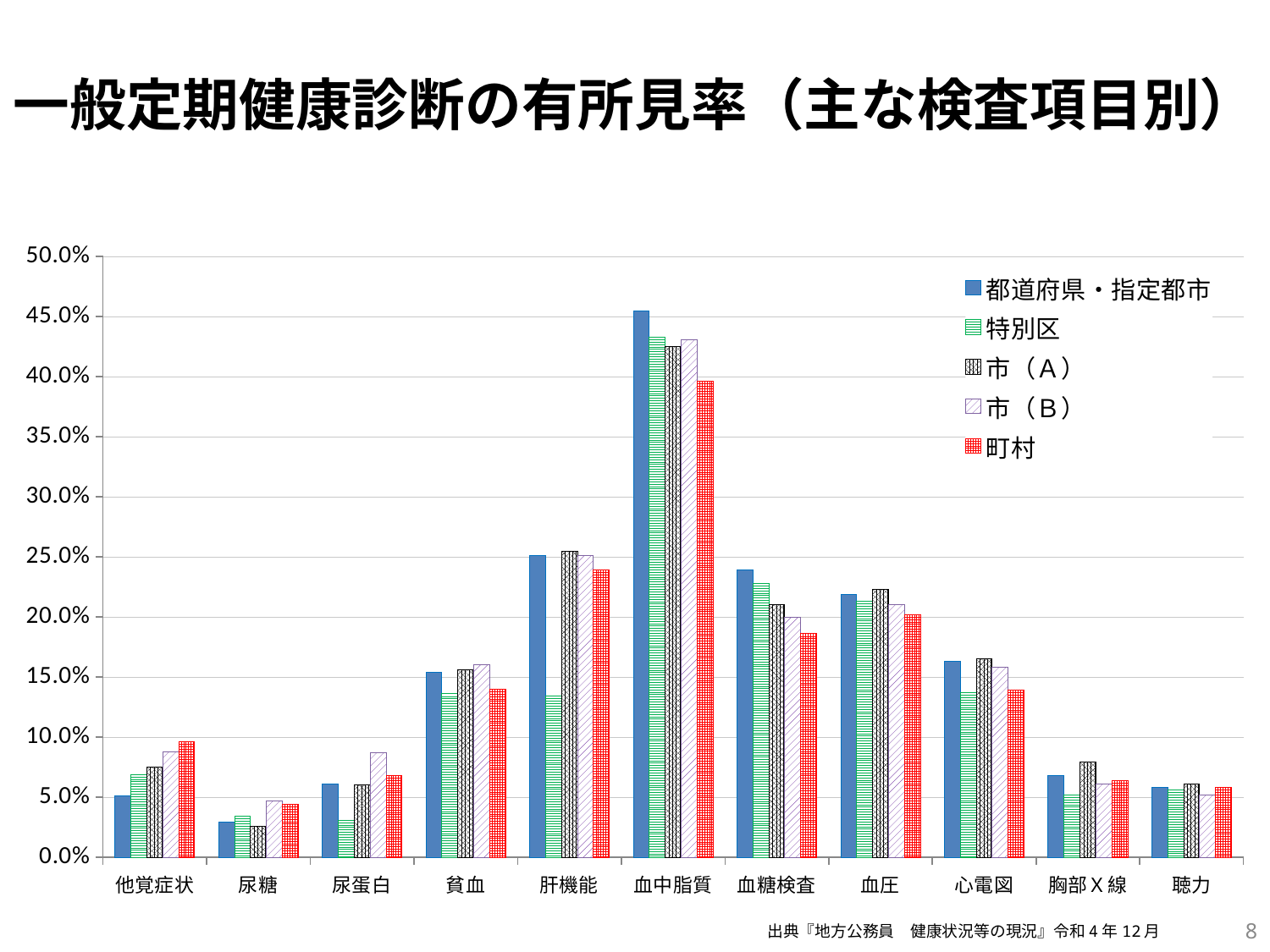
Is the value for 都道府県・指定都市 in 血中脂質 greater or less than 40.0%? greater Which category has the highest values across all series? 血中脂質 How many categories are shown on the x axis of the chart? 11 Is the value for 町村 in 血中脂質 greater or less than 35.0%? greater In 他覚症状, which is larger: the value for 町村 or the value for 都道府県・指定都市? 町村 What kind of chart is shown on the slide? bar chart How many series does the legend list? 5 Which series is shown in solid blue in the legend? 都道府県・指定都市 Is the value for 都道府県・指定都市 in 肝機能 greater or less than 20.0%? greater Which category has the lowest values across all series? 尿糖 In 心電図, which is larger: the value for 都道府県・指定都市 or the value for 特別区? 都道府県・指定都市